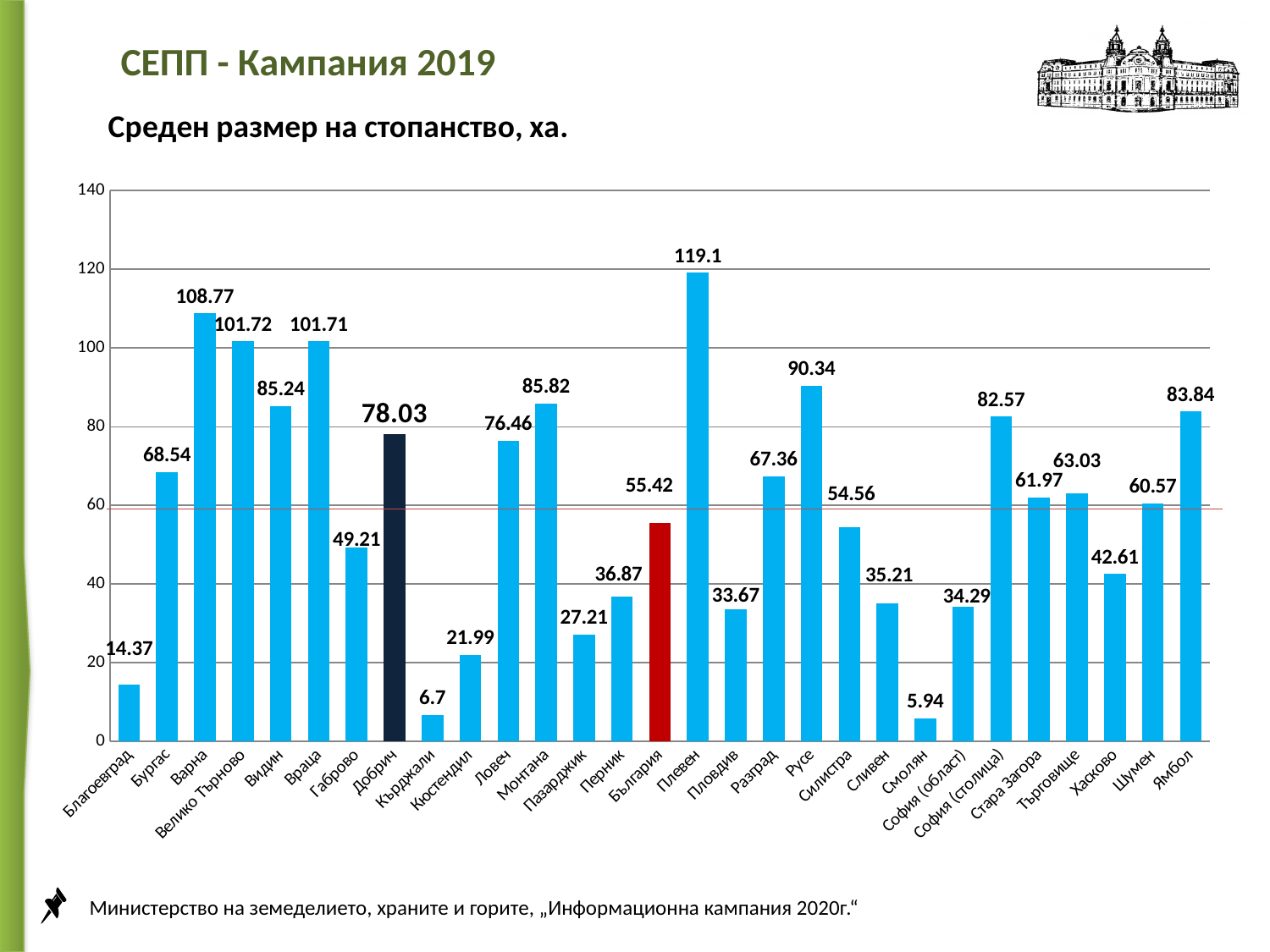
Which is larger, the value for Русе or the value for Ямбол? Русе What is the value for Добрич? 78.03 Which category has the highest value? Плевен What is the difference between the values for Варна and Бургас? 40.23 What is the value for Плевен? 119.1 What is the title of the chart? Среден размер на стопанство, ха. What is the value for България? 55.42 What is the value for Кърджали? 6.7 Is the value for Силистра greater or less than 60? less How many categories are shown on the x axis? 29 Which category has the lowest value? Смолян What kind of chart is shown on the slide? bar chart